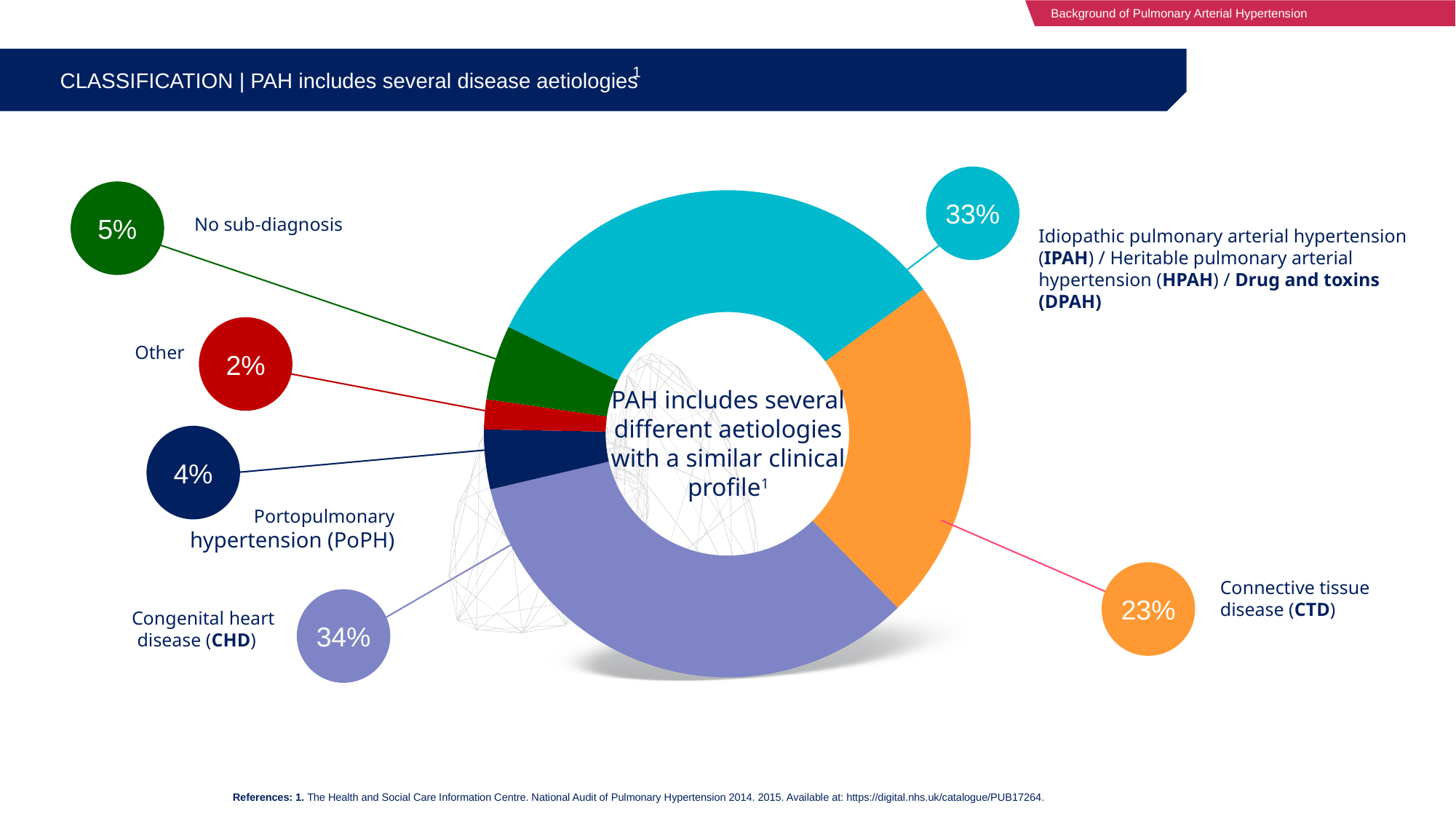
What text is written in the centre of the donut chart? PAH includes several different aetiologies with a similar clinical profile How many categories are shown in the chart? 6 What percentage is shown for idiopathic / heritable pulmonary arterial hypertension / drug and toxins (IPAH/HPAH/DPAH)? 33% What percentage is shown for 'No sub-diagnosis'? 5% What percentage is shown for portopulmonary hypertension (PoPH)? 4% Which category has the smallest share of the chart? Other (2%) What percentage is shown for connective tissue disease (CTD)? 23% What kind of chart is shown on the slide? Donut (pie) chart What percentage of PAH cases is attributed to congenital heart disease (CHD)? 34% Which category has the largest share of the chart? Congenital heart disease (CHD) (34%) Which is larger, the share for 'No sub-diagnosis' or the share for PoPH? No sub-diagnosis (5%) What is the difference in percentage points between CHD and CTD? 11 percentage points